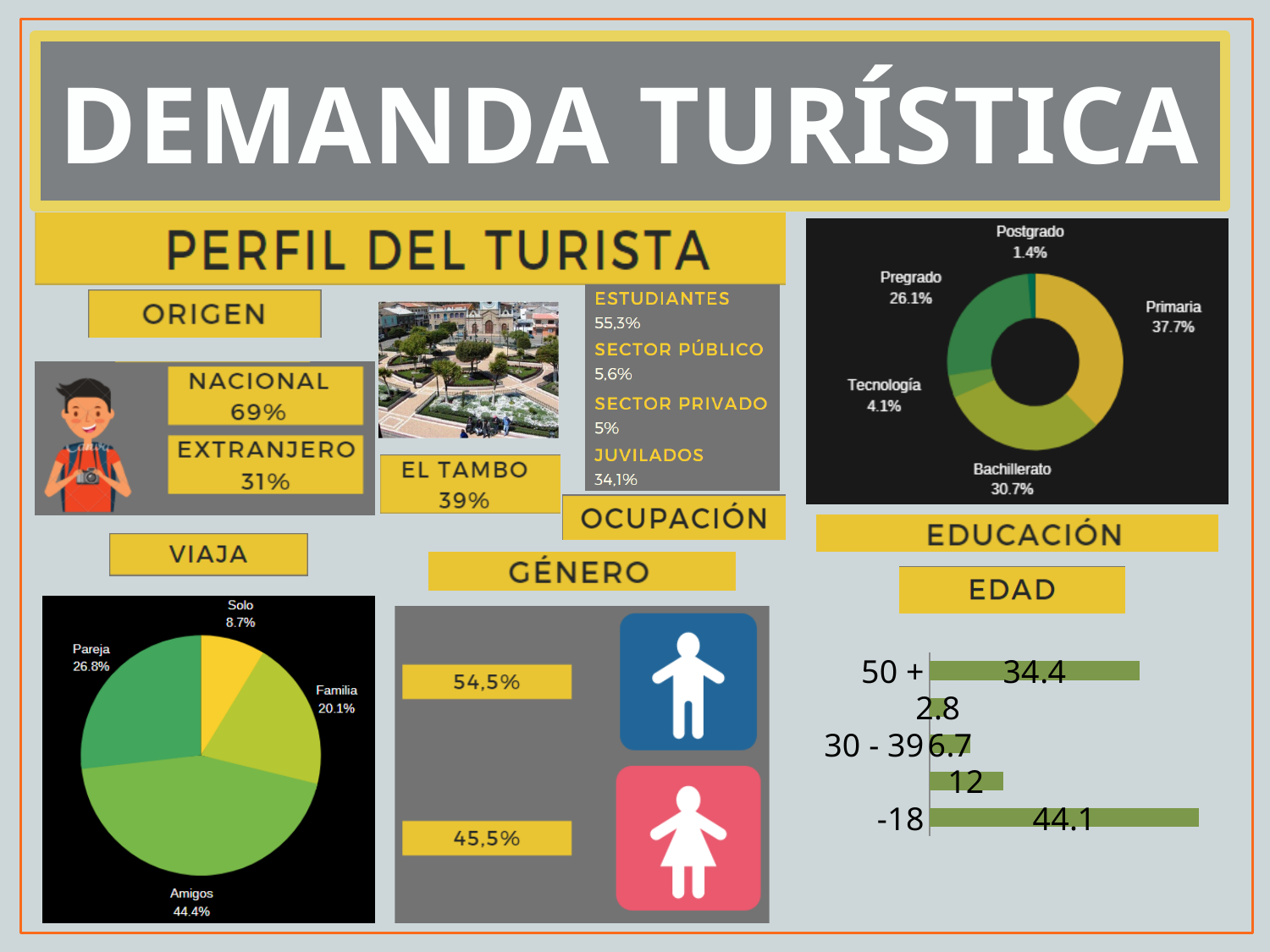
In the Viaja pie chart, what is the difference between the Familia and Solo shares? 11.4% How many categories does the Educación donut chart show? 5 In the Edad bar chart, what is the value for the 30 - 39 category? 6.7 In the Viaja pie chart, what percentage of tourists travel with Amigos? 44.4% In the Viaja pie chart, which is larger, Pareja or Familia? Pareja In the Edad bar chart, which is larger, 50 + or 30 - 39? 50 + In the Educación donut chart, which education level has the smallest share? Postgrado In the Viaja pie chart, which category has the largest share? Amigos In the Educación donut chart, what percentage is shown for Primaria? 37.7% In the Educación donut chart, what is the difference between the Pregrado and Tecnología percentages? 22.0% In the Edad bar chart, what is the value for the -18 category? 44.1 What type of chart is the Viaja chart? Pie chart